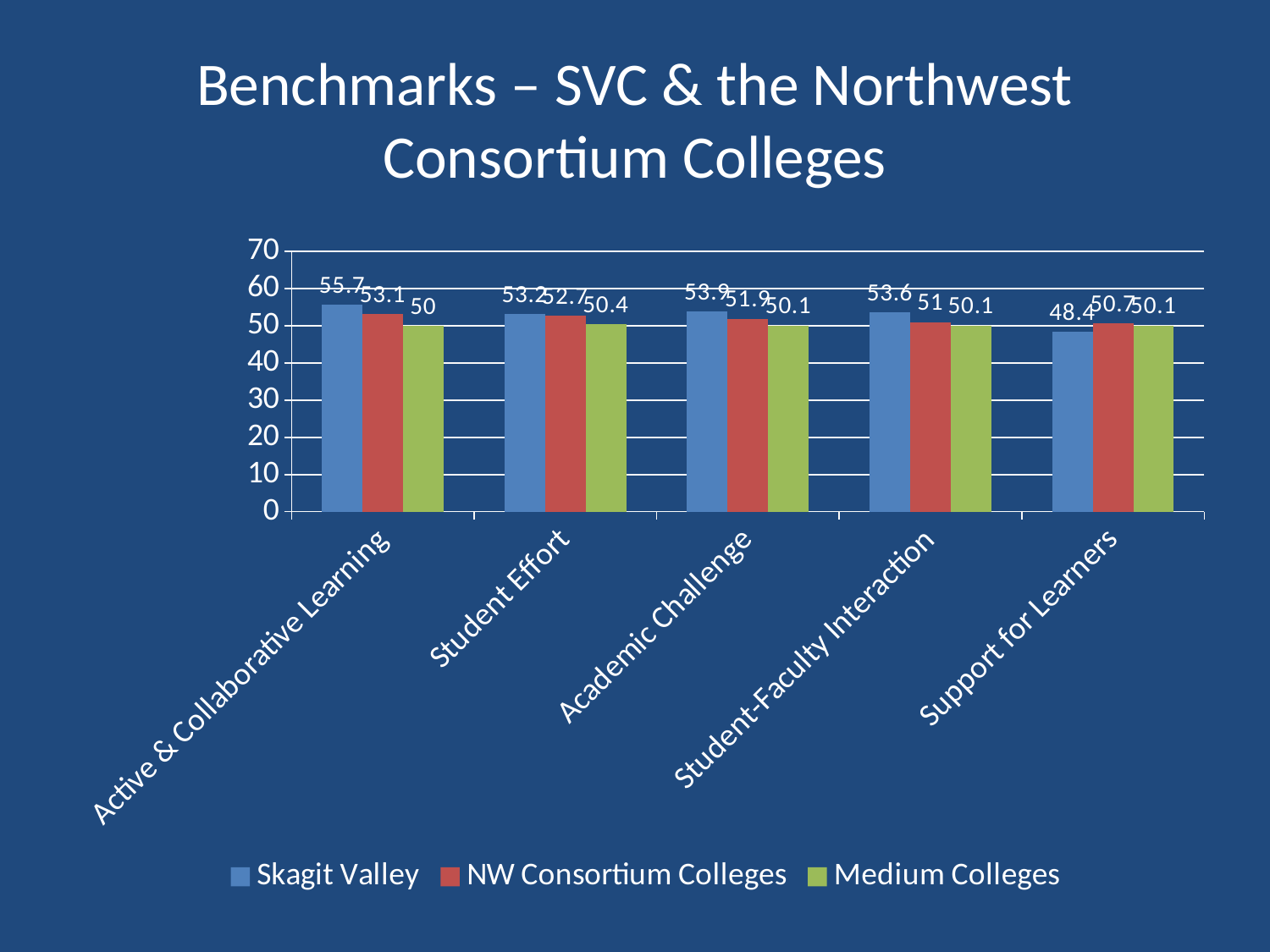
What is the value for NW Consortium Colleges in the Student-Faculty Interaction category? 51 What is the difference between the Skagit Valley and Medium Colleges values for Active & Collaborative Learning? 5.7 What is the value for Skagit Valley in the Active & Collaborative Learning category? 55.7 What kind of chart is shown on the slide? bar chart How many categories are shown on the x axis? 5 In which category does Skagit Valley have its highest value? Active & Collaborative Learning What is the value for Medium Colleges in the Student Effort category? 50.4 For Support for Learners, which is larger: Skagit Valley or NW Consortium Colleges? NW Consortium Colleges In which category does Skagit Valley have its lowest value? Support for Learners Is the Skagit Valley value for Support for Learners greater or less than 50? less How many series does the legend list? 3 Which series is shown in green in the legend? Medium Colleges